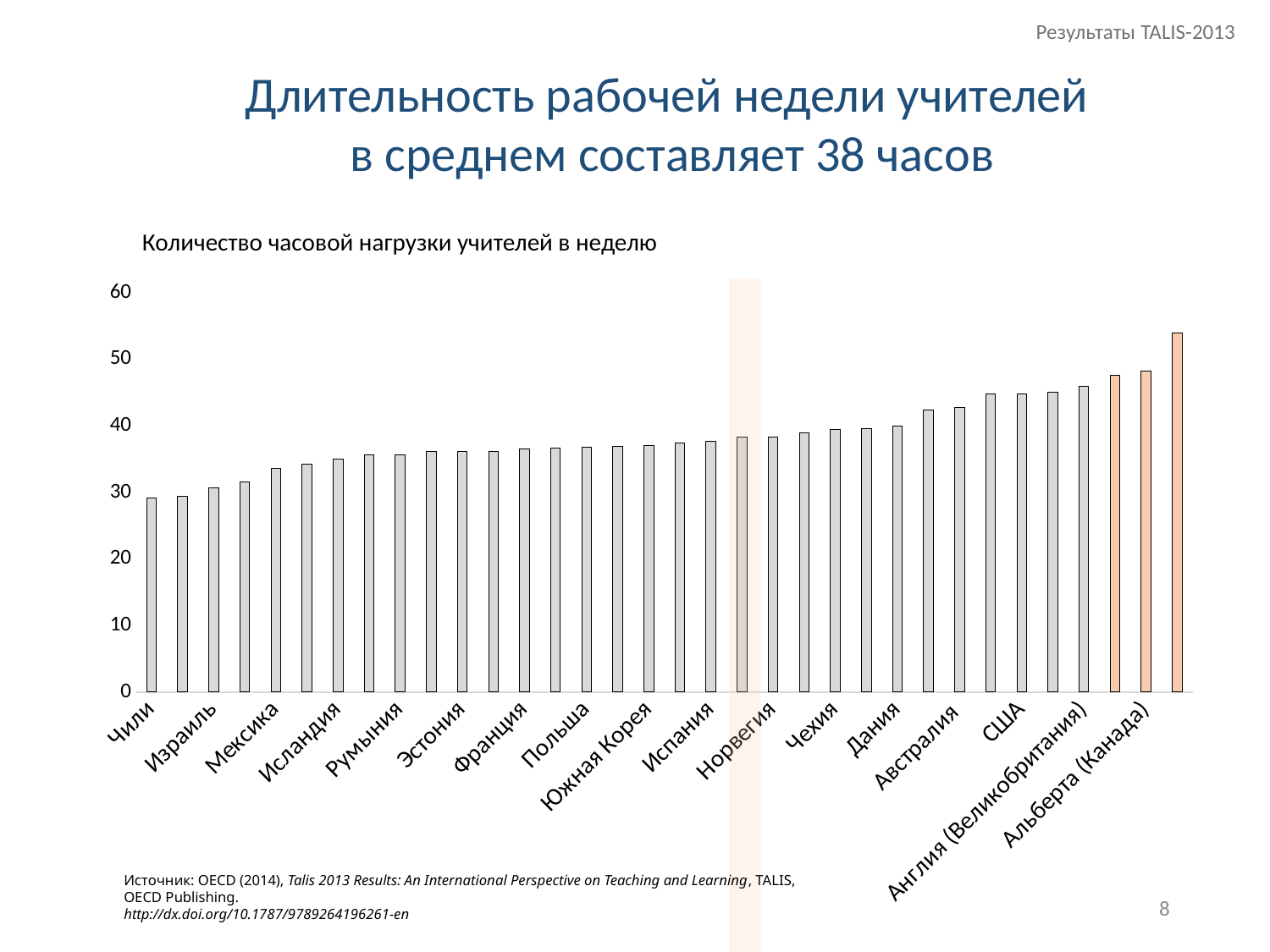
What kind of chart is shown on the slide? bar chart What is the title printed above the chart? Количество часовой нагрузки учителей в неделю Is the value for Норвегия greater or less than 40? less Is the value for Альберта (Канада) greater or less than 40? greater Which has a larger value, США or Испания? США Do the values rise or fall from left to right along the x axis? rise Which has a larger value, Альберта (Канада) or Чили? Альберта (Канада) Is the value for Англия (Великобритания) greater or less than 50? less